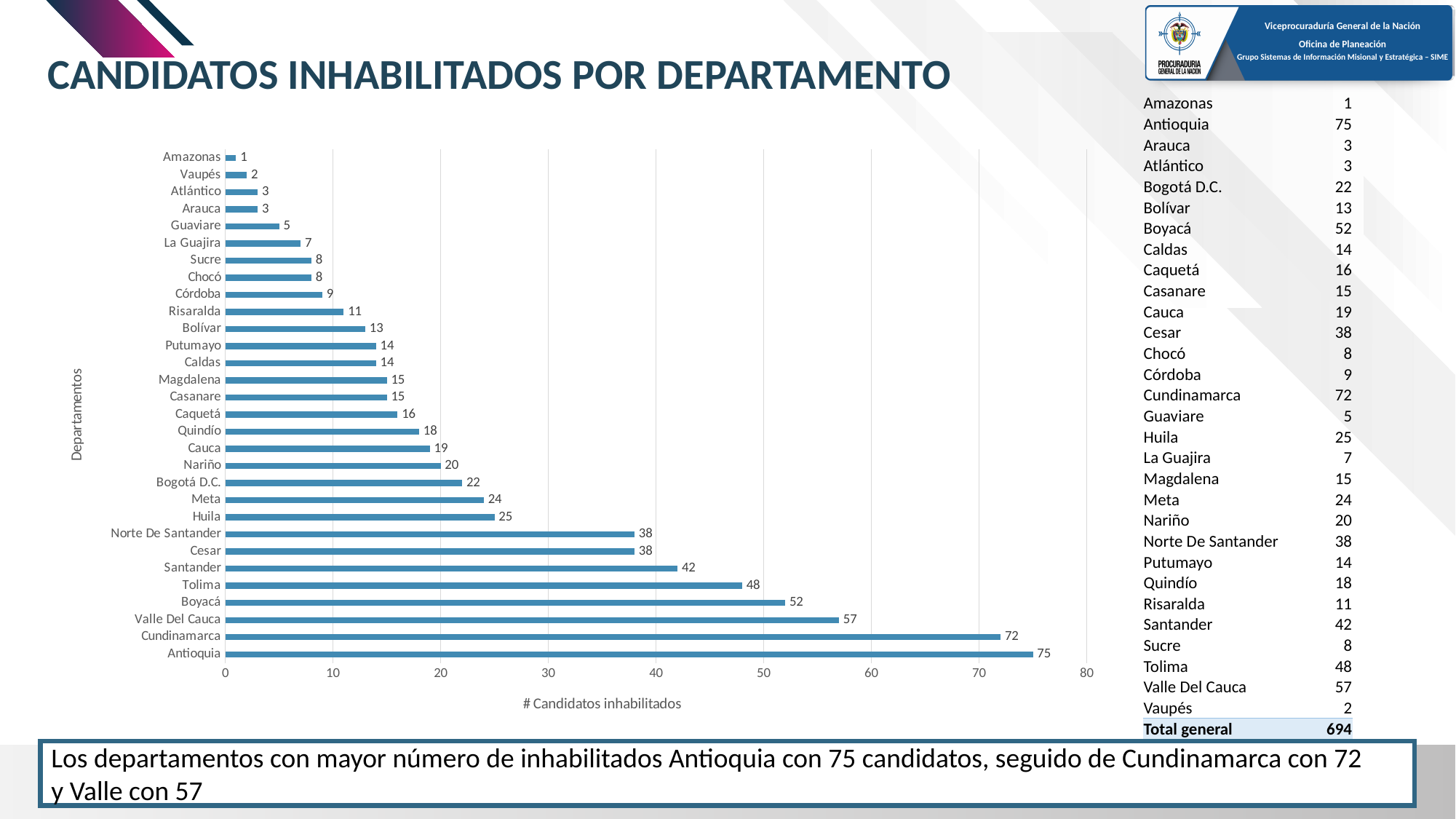
What is the label of the horizontal axis? # Candidatos inhabilitados What type of chart is shown on the slide? Bar chart What is the value for Nariño? 20 What is the difference between the values for Valle Del Cauca and Santander? 15 How many departments are plotted in the chart? 30 Which department has the lowest number of candidatos inhabilitados? Amazonas Which department has the highest number of candidatos inhabilitados? Antioquia How many candidatos inhabilitados does Tolima have? 48 Which has a larger value, Huila or Meta? Huila What is the value for Boyacá? 52 What is the title of the chart? CANDIDATOS INHABILITADOS POR DEPARTAMENTO What is the difference between the values for Antioquia and Cundinamarca? 3